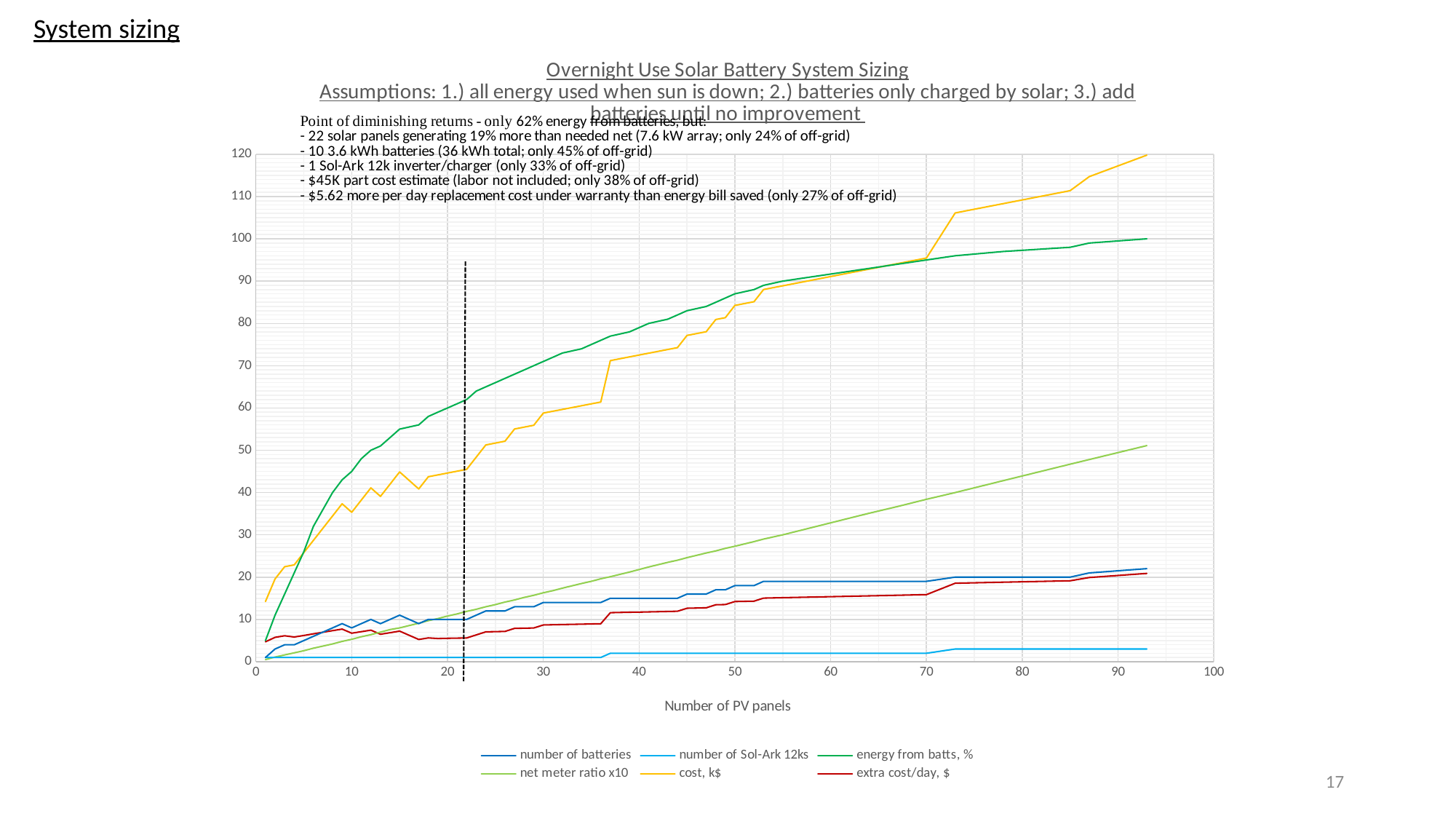
At 90 PV panels, which is larger: 'cost, k$' or 'energy from batts, %'? cost, k$ How many series does the chart legend list? 6 At 30 PV panels, which is larger: 'cost, k$' or 'energy from batts, %'? energy from batts, % Is the value of 'cost, k$' at 90 PV panels greater or less than 110? greater What is the first line of the chart title? Overnight Use Solar Battery System Sizing Is the value of 'energy from batts, %' at 90 PV panels greater or less than 90? greater Does the 'energy from batts, %' line rise or fall as the number of PV panels increases? rises What kind of chart is shown on the slide? line chart Is the value of 'net meter ratio x10' at 80 PV panels greater or less than 40? greater What is the label of the x axis? Number of PV panels Does the 'net meter ratio x10' line rise or fall along the x axis? rises